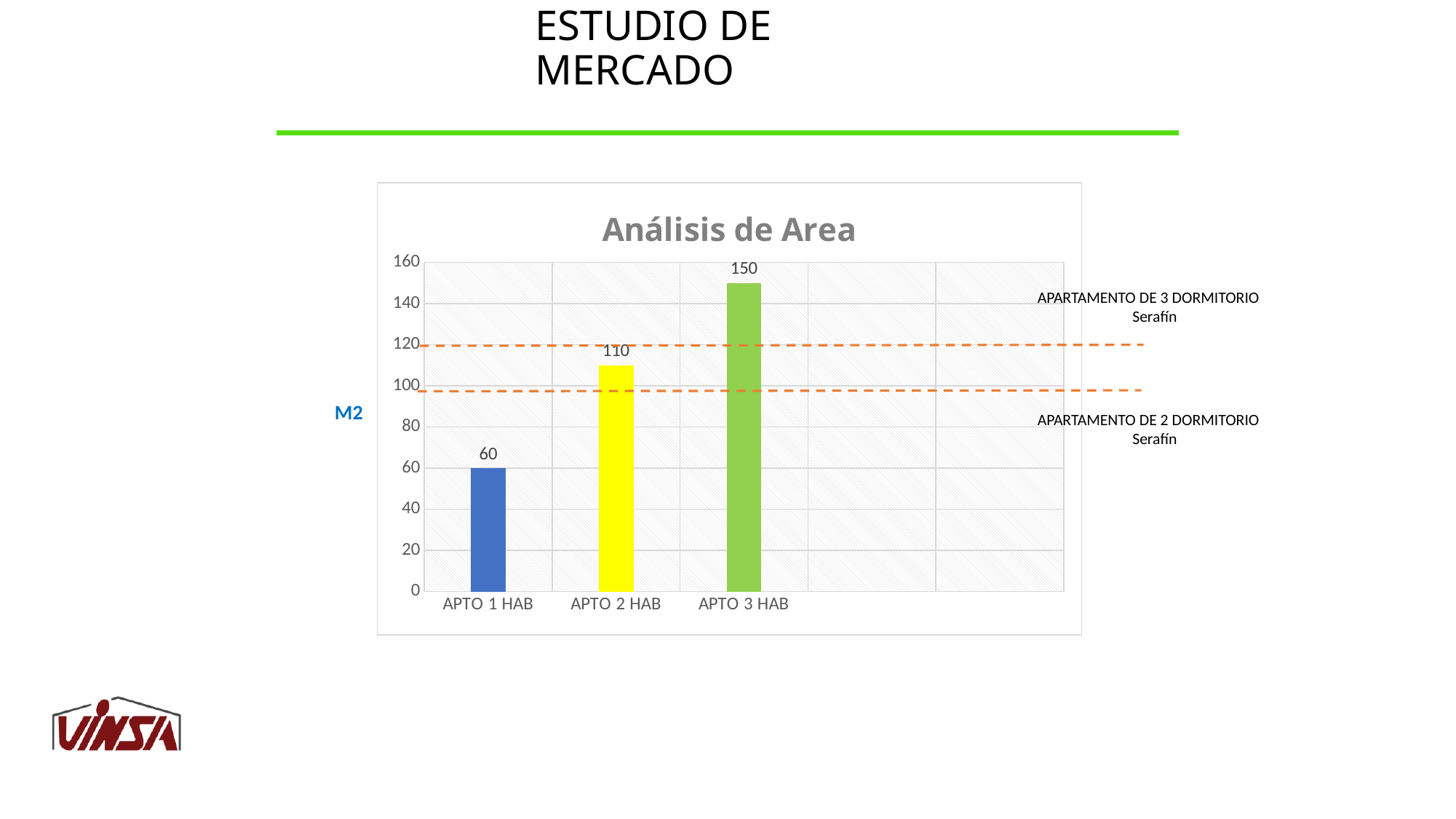
What is the value for APTO 2 HAB? 110 What is the value for APTO 1 HAB? 60 How many categories are shown on the x axis? 3 Which is larger, the value for APTO 2 HAB or APTO 3 HAB? APTO 3 HAB What is the difference between the values for APTO 2 HAB and APTO 1 HAB? 50 What is the title of the chart? Análisis de Area What kind of chart is shown on the slide? bar chart Which category has the lowest value? APTO 1 HAB Is the value for APTO 2 HAB greater or less than 100? greater What is the value for APTO 3 HAB? 150 What is the difference between the values for APTO 3 HAB and APTO 1 HAB? 90 Which category has the highest value? APTO 3 HAB